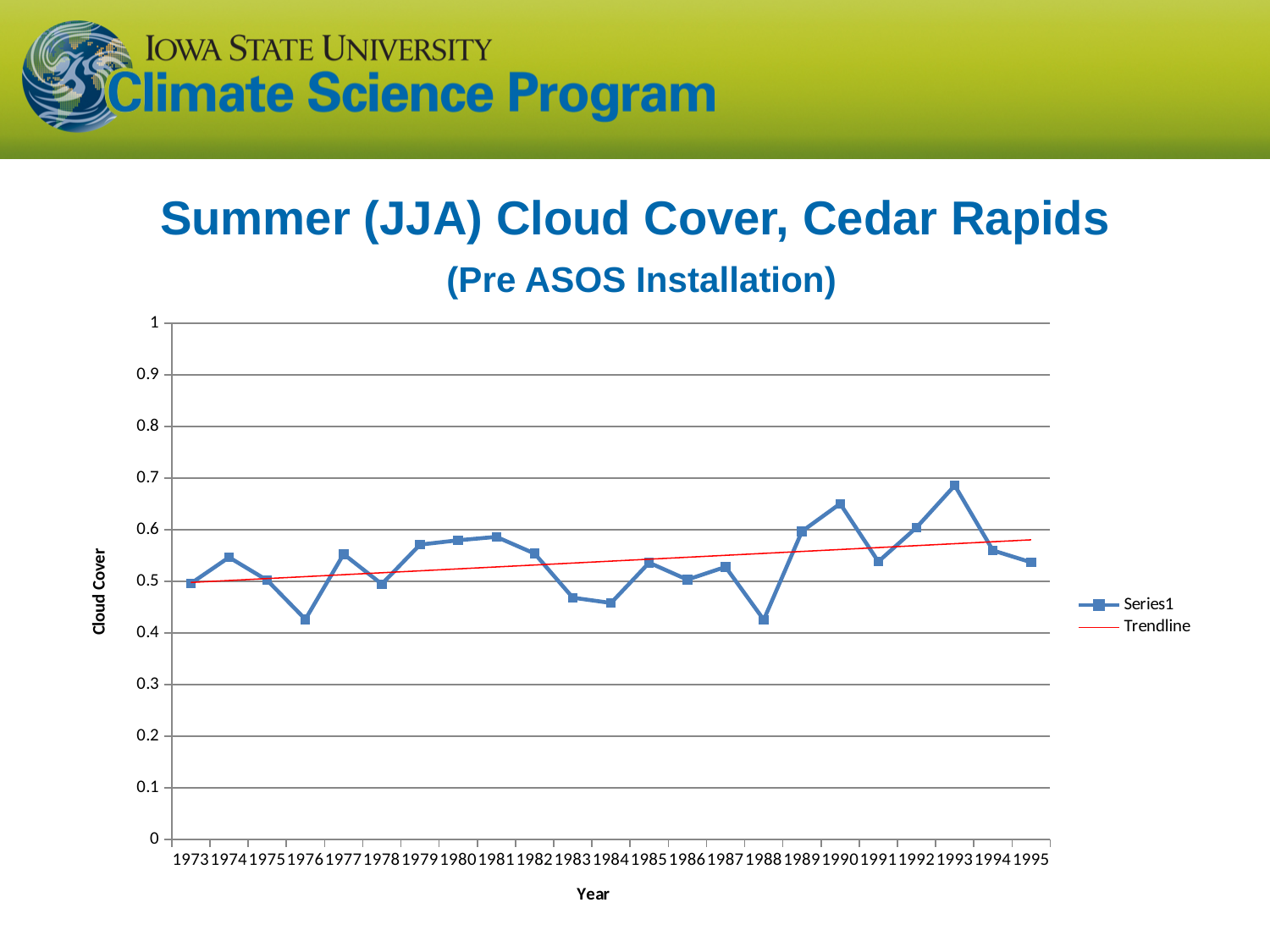
Is the cloud cover value for 1993 greater or less than 0.6? greater What is the title of the chart on the slide? Summer (JJA) Cloud Cover, Cedar Rapids (Pre ASOS Installation) Is the cloud cover value for 1984 greater or less than 0.5? less What is the label of the chart's vertical axis? Cloud Cover Does the red trendline rise or fall from 1973 to 1995? Rises Which year has the larger cloud cover value, 1990 or 1984? 1990 How many years are plotted on the x axis of the chart? 23 Is the cloud cover value for 1990 greater or less than 0.6? greater How many entries does the chart's legend list? 2 Which year has the highest cloud cover value in the chart? 1993 What kind of chart is shown on the slide? Line chart